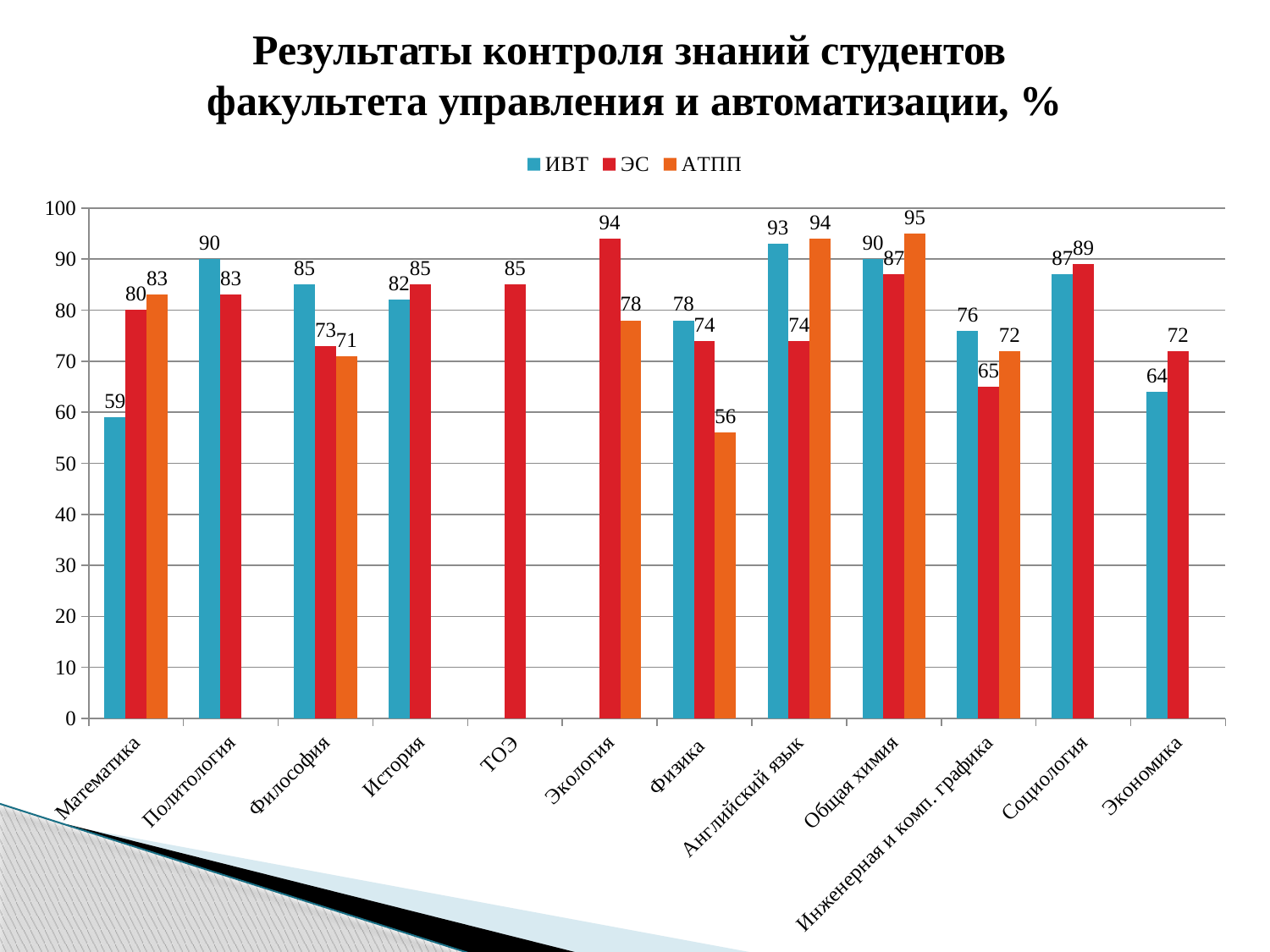
What is the difference between the ЭС and ИВТ values in Экономика? 8 What is the value for АТПП in Общая химия? 95 What is the difference between the ИВТ and АТПП values in Физика? 22 In which subject does АТПП have its lowest value? Физика Which series is shown in orange in the legend? АТПП How many subject categories are shown on the x axis? 12 What is the value for ЭС in Экология? 94 What is the value for ИВТ in Математика? 59 What type of chart is shown on the slide? bar chart Which is larger in Инженерная и комп. графика: the ИВТ value or the ЭС value? ИВТ In which subject does ИВТ have its highest value? Английский язык How many series does the legend list? 3